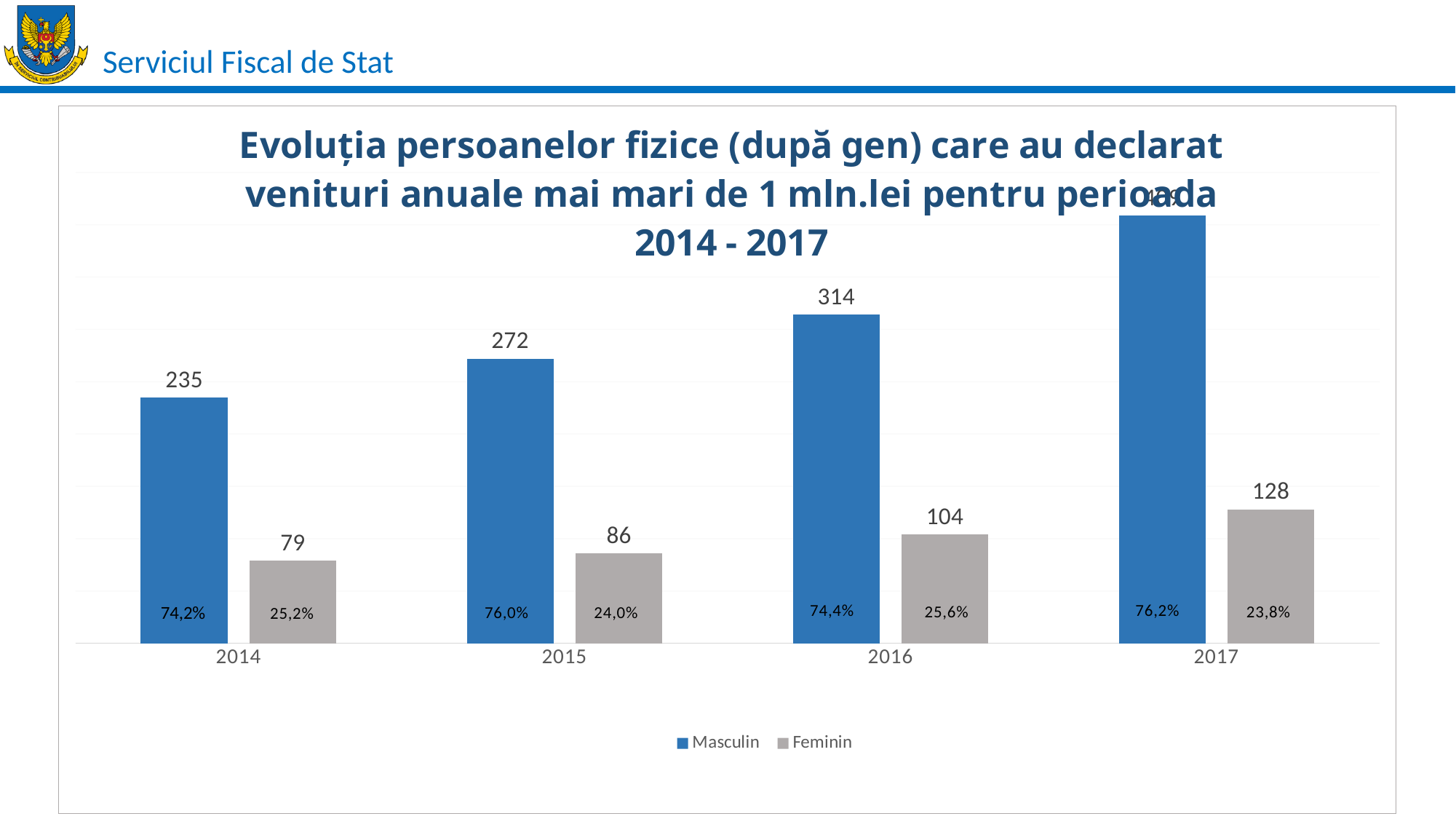
What is the difference between the Feminin values for 2017 and 2014? 49 How many series does the legend list? 2 What is the Masculin value for 2016? 314 What is the Masculin value for 2014? 235 Which year has the highest Feminin value? 2017 Do the Feminin values rise or fall from 2014 to 2017? rise Which year has the lowest Masculin value? 2014 How many years are shown on the x axis? 4 What percentage label is shown on the Feminin bar for 2017? 23,8% Which is larger, the Masculin value for 2015 or the Masculin value for 2016? 2016 What is the Feminin value for 2016? 104 What percentage label is shown on the Masculin bar for 2015? 76,0%